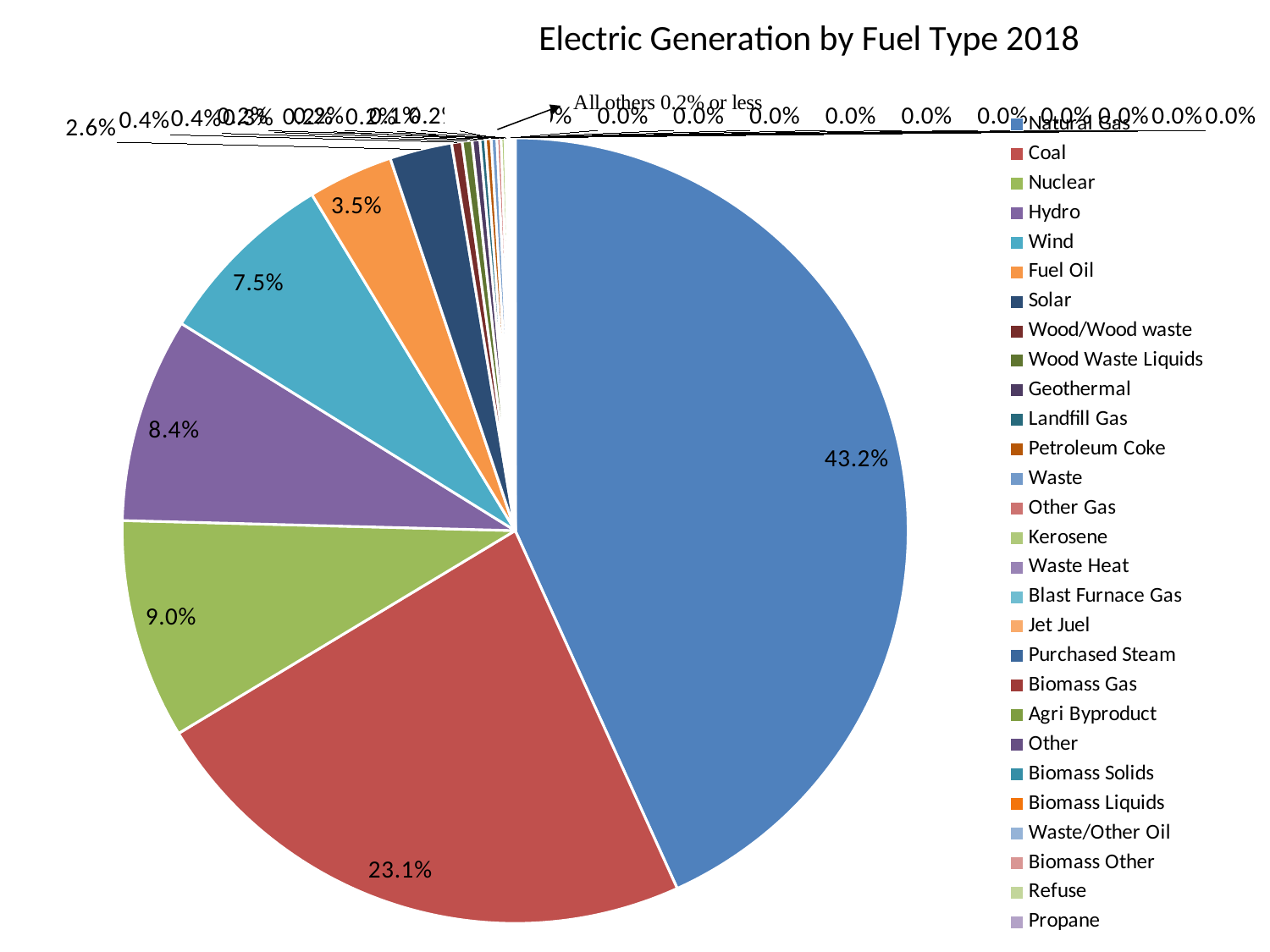
What is the title of the chart? Electric Generation by Fuel Type 2018 What percentage of the pie is Coal? 23.1% Which is larger, the share for Hydro or the share for Wind? Hydro What is the value shown for Wind? 7.5% What is the difference between the Natural Gas share and the Coal share? 20.1% How many fuel types are listed in the legend? 28 Which fuel type has the largest slice of the pie? Natural Gas What is the value shown for Fuel Oil? 3.5% What kind of chart is shown on the slide? pie chart What is the value shown for Nuclear? 9.0% What is the value shown for Hydro? 8.4% What share of electric generation does Natural Gas account for? 43.2%